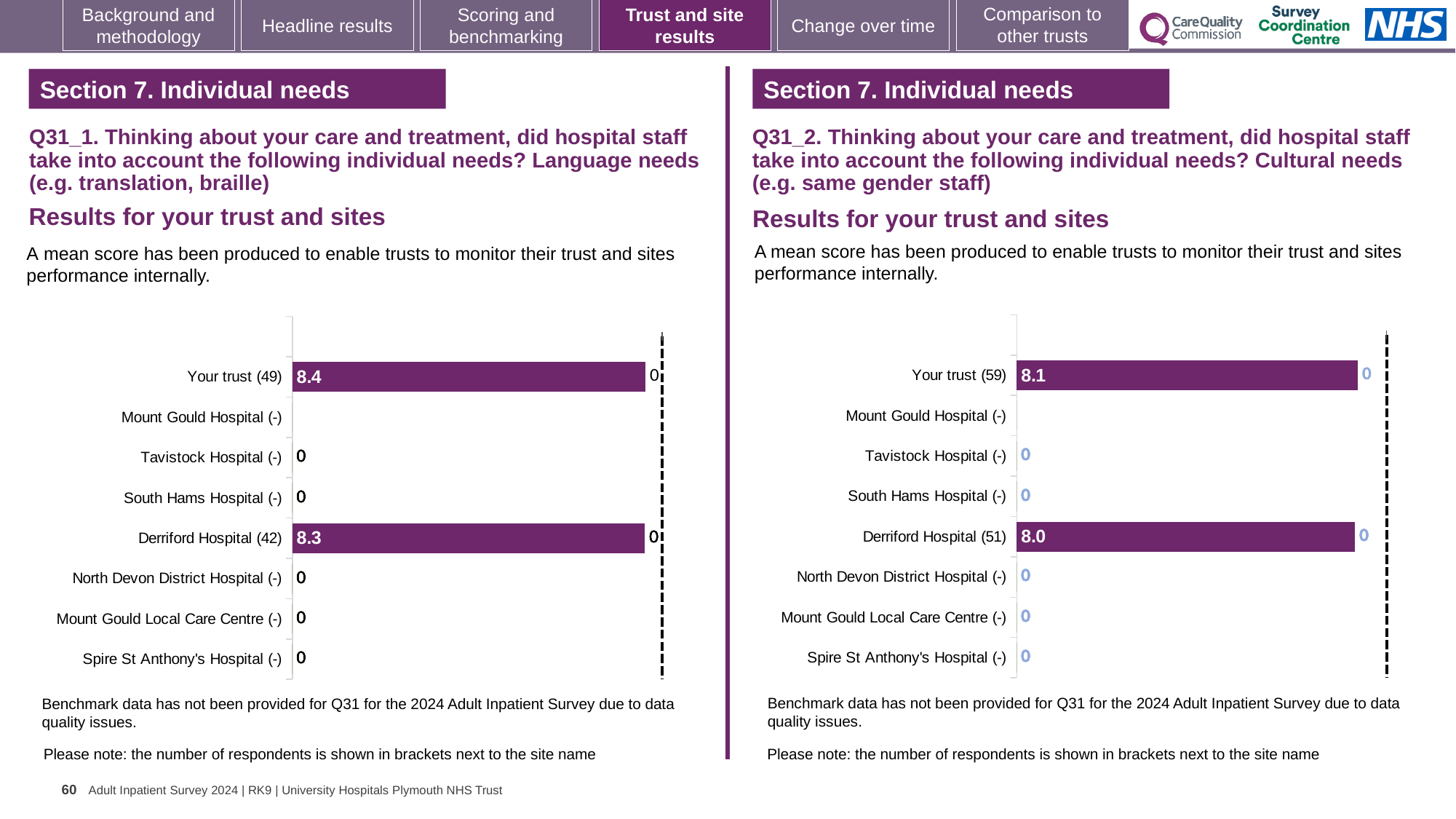
On the left chart (Q31_1, Language needs), what is the mean score for Derriford Hospital? 8.3 On the right chart (Q31_2, Cultural needs), how many respondents are shown in brackets for Derriford Hospital? 51 On the left chart (Q31_1, Language needs), which site has the highest mean score? Your trust On the right chart (Q31_2, Cultural needs), what is the mean score for Your trust? 8.1 On the left chart (Q31_1, Language needs), how many site categories are listed on the vertical axis? 8 What type of chart is used on the right (Q31_2, Cultural needs)? Bar chart Is the Your trust score higher on the left chart (Q31_1, Language needs) or on the right chart (Q31_2, Cultural needs)? Left chart (Q31_1, Language needs) On the left chart (Q31_1, Language needs), what is the mean score for Your trust? 8.4 On the left chart (Q31_1, Language needs), what is the difference between the scores for Your trust and Derriford Hospital? 0.1 On the right chart (Q31_2, Cultural needs), what is the mean score for Derriford Hospital? 8.0 On the left chart (Q31_1, Language needs), how many respondents are shown in brackets for Your trust? 49 On the right chart (Q31_2, Cultural needs), what is the difference between the scores for Your trust and Derriford Hospital? 0.1